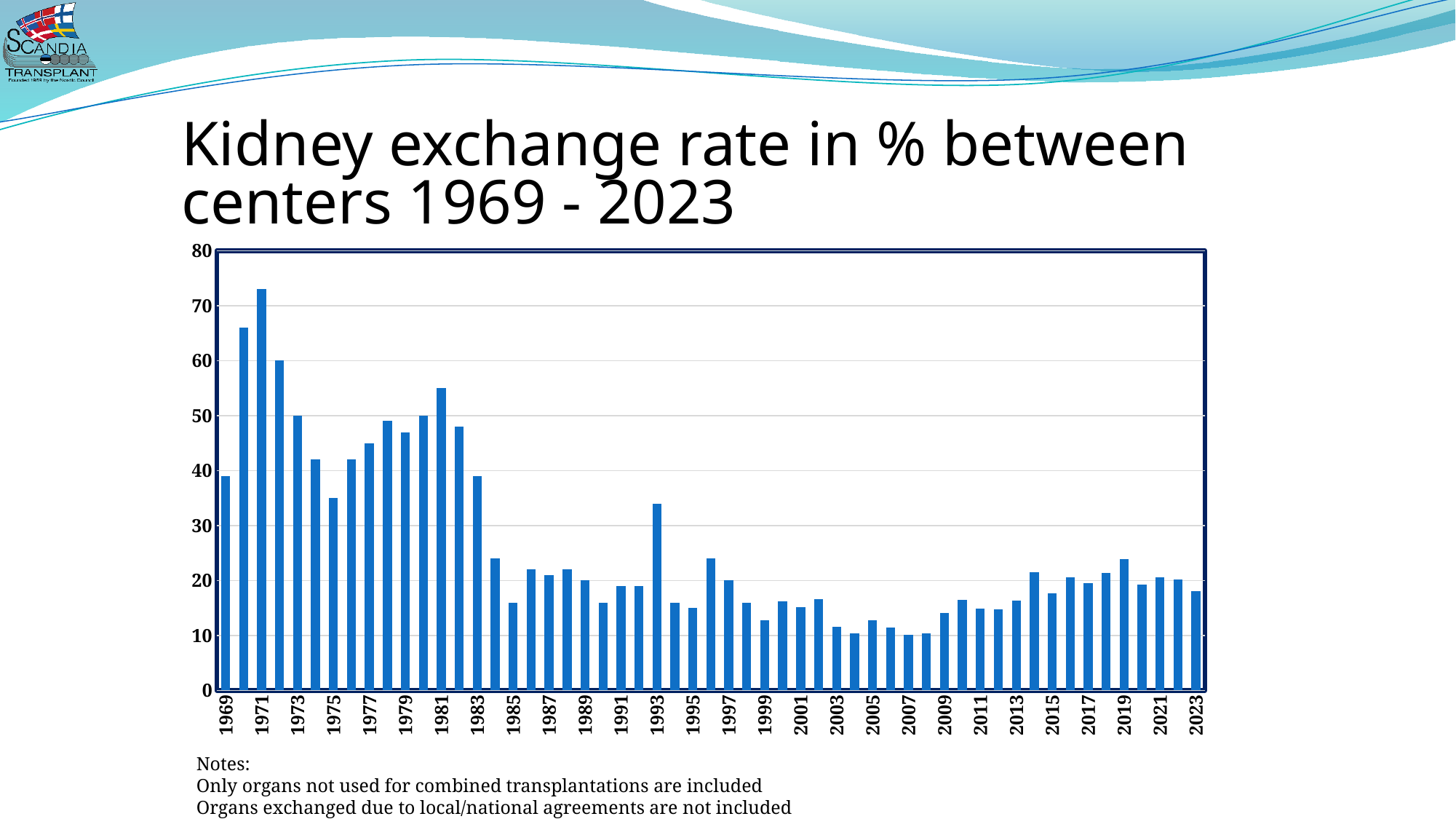
Is the value for 1975 greater or less than 40? less Is the value for 2007 greater or less than 20? less Which year has the larger value, 1993 or 1995? 1993 Overall, do the values rise or fall from 1969 to 2023? fall Is the value for 1970 greater or less than 60? greater What kind of chart is shown on the slide? bar chart Which year has the highest kidney exchange rate? 1971 What is the title of the chart? Kidney exchange rate in % between centers 1969 - 2023